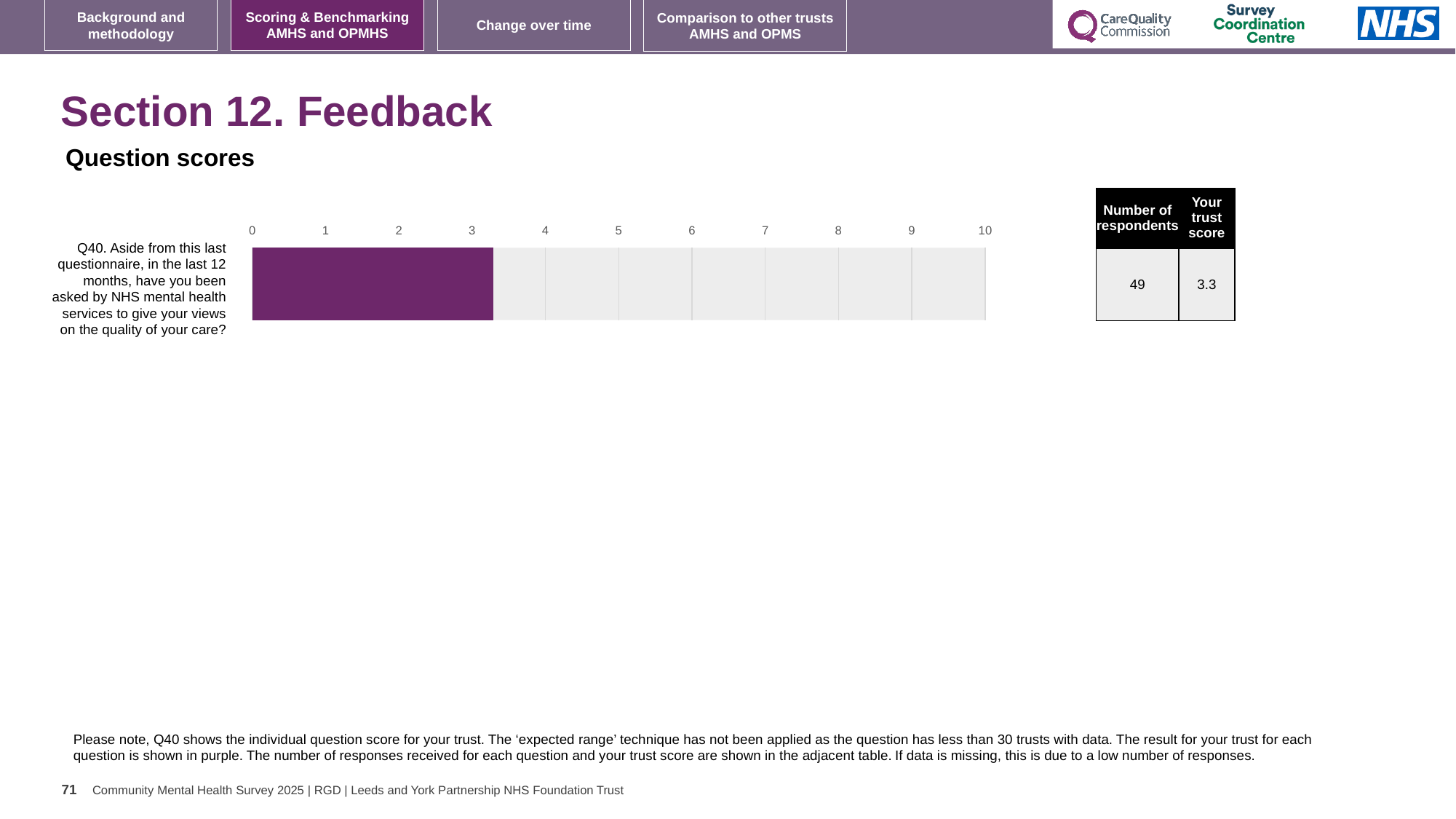
What is the maximum value shown on the chart's horizontal axis? 10 How many respondents answered Q40 according to the table? 49 What colour is the bar showing the trust's result for Q40? purple What is the trust score for Q40 shown in the table next to the chart? 3.3 Is the value for Q40 greater or less than 2? greater What kind of chart is used to show the Q40 question score? bar chart How many questions (bars) are plotted on the chart? 1 Is the value for Q40 greater or less than 5? less